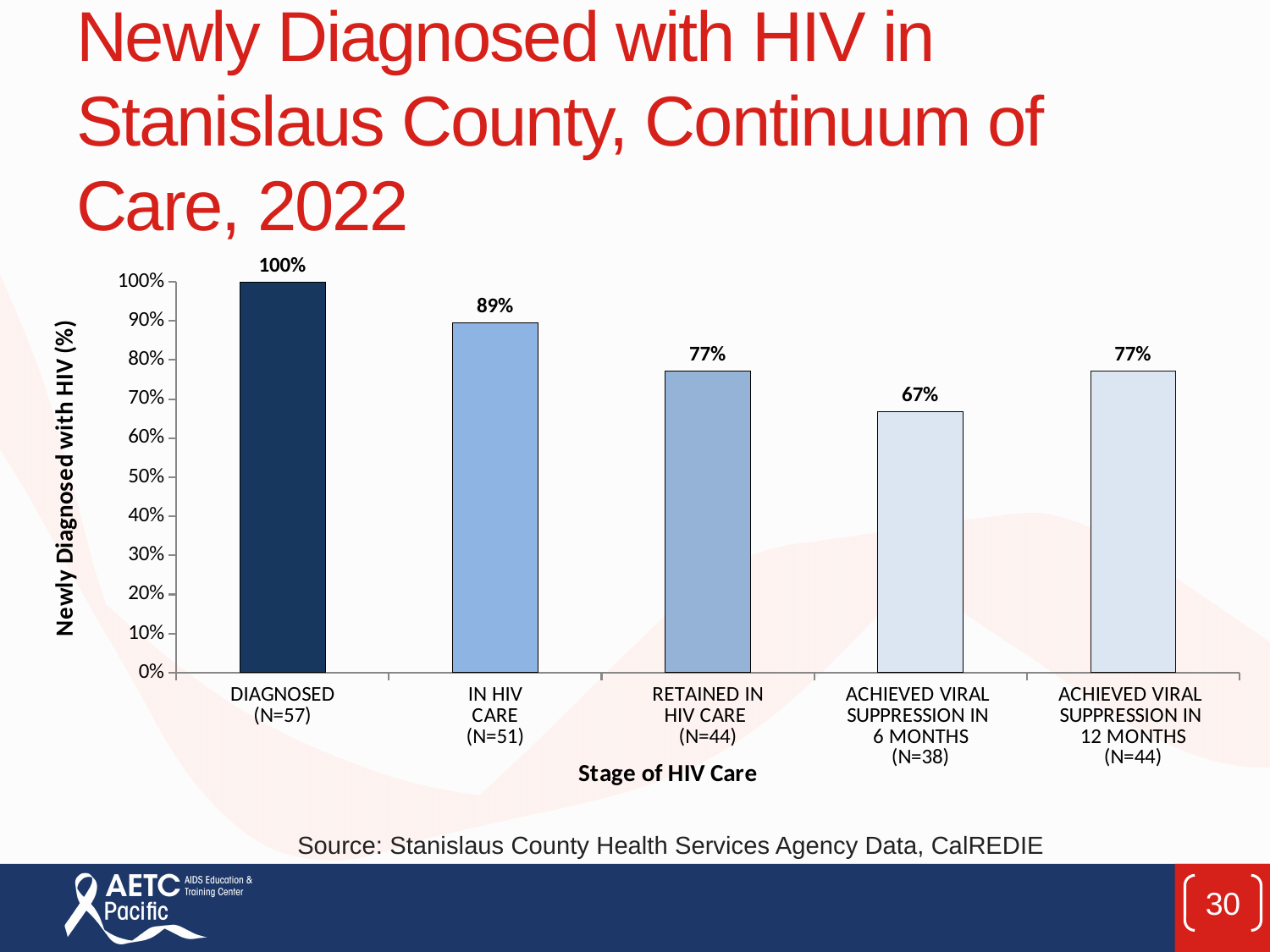
Which stage of HIV care has the lowest percentage? Achieved Viral Suppression in 6 Months Which stage of HIV care has the highest percentage? Diagnosed Which is larger, the value for In HIV Care or the value for Retained in HIV Care? In HIV Care What kind of chart is shown on the slide? Bar chart What is the N value shown for the Diagnosed category? N=57 What is the difference in percentage points between Achieved Viral Suppression in 12 Months and Achieved Viral Suppression in 6 Months? 10 How many stages of HIV care are shown on the x axis? 5 What is the difference in percentage points between Diagnosed and In HIV Care? 11 What percentage of newly diagnosed people were in HIV care? 89% What percentage achieved viral suppression in 6 months? 67% What is the value for Achieved Viral Suppression in 12 Months? 77% What is the value for Retained in HIV Care? 77%